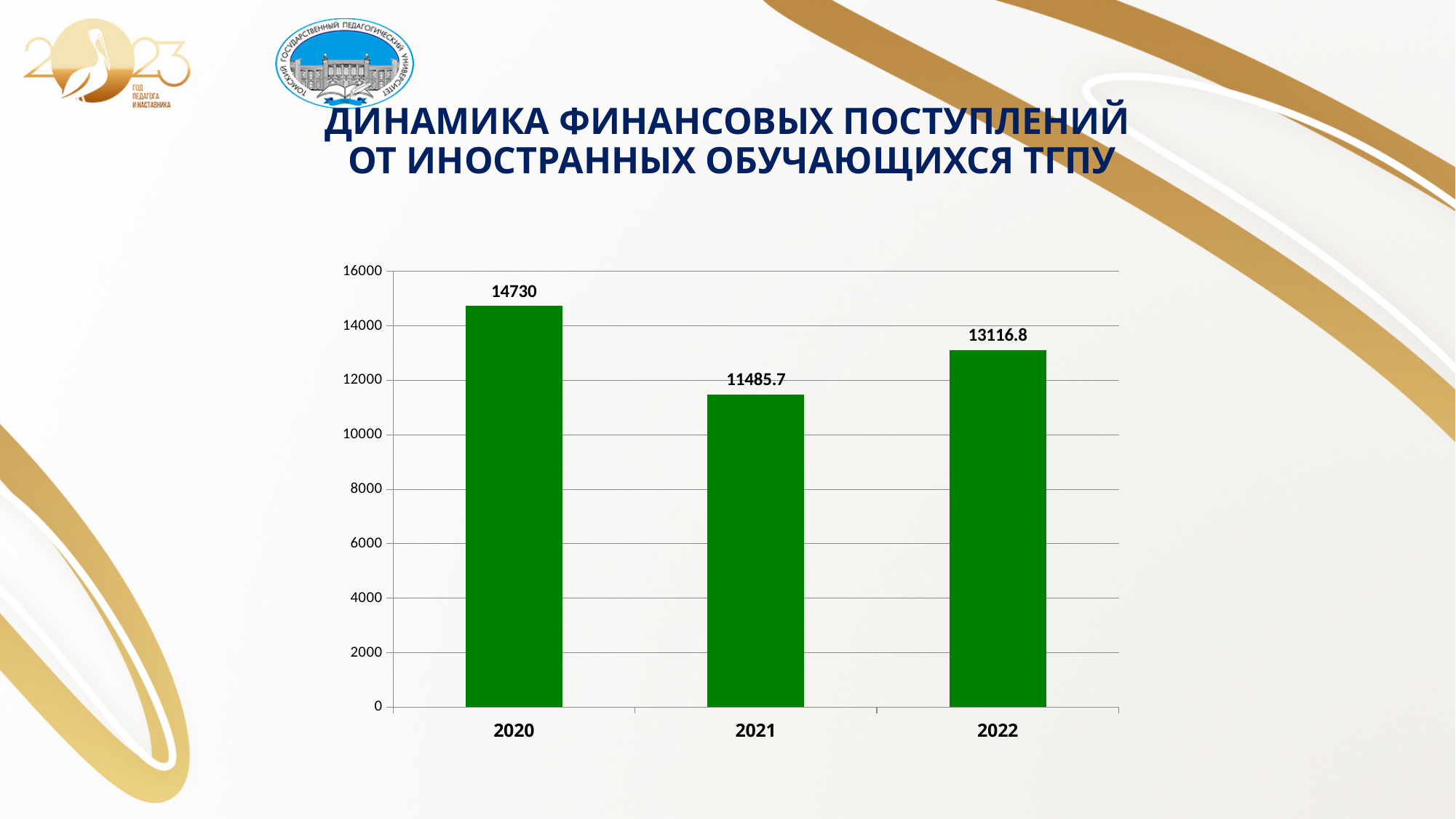
How many years are shown on the x axis? 3 What is the value for 2021? 11485.7 What is the difference between the values for 2022 and 2021? 1631.1 What is the difference between the values for 2020 and 2021? 3244.3 Which year has the highest value? 2020 What is the value for 2022? 13116.8 What colour are the bars in the chart? green Which year has the lowest value? 2021 What kind of chart is shown on the slide? bar chart Is the value for 2021 greater or less than 12000? less What is the value for 2020? 14730 Which is larger, the value for 2022 or the value for 2021? 2022